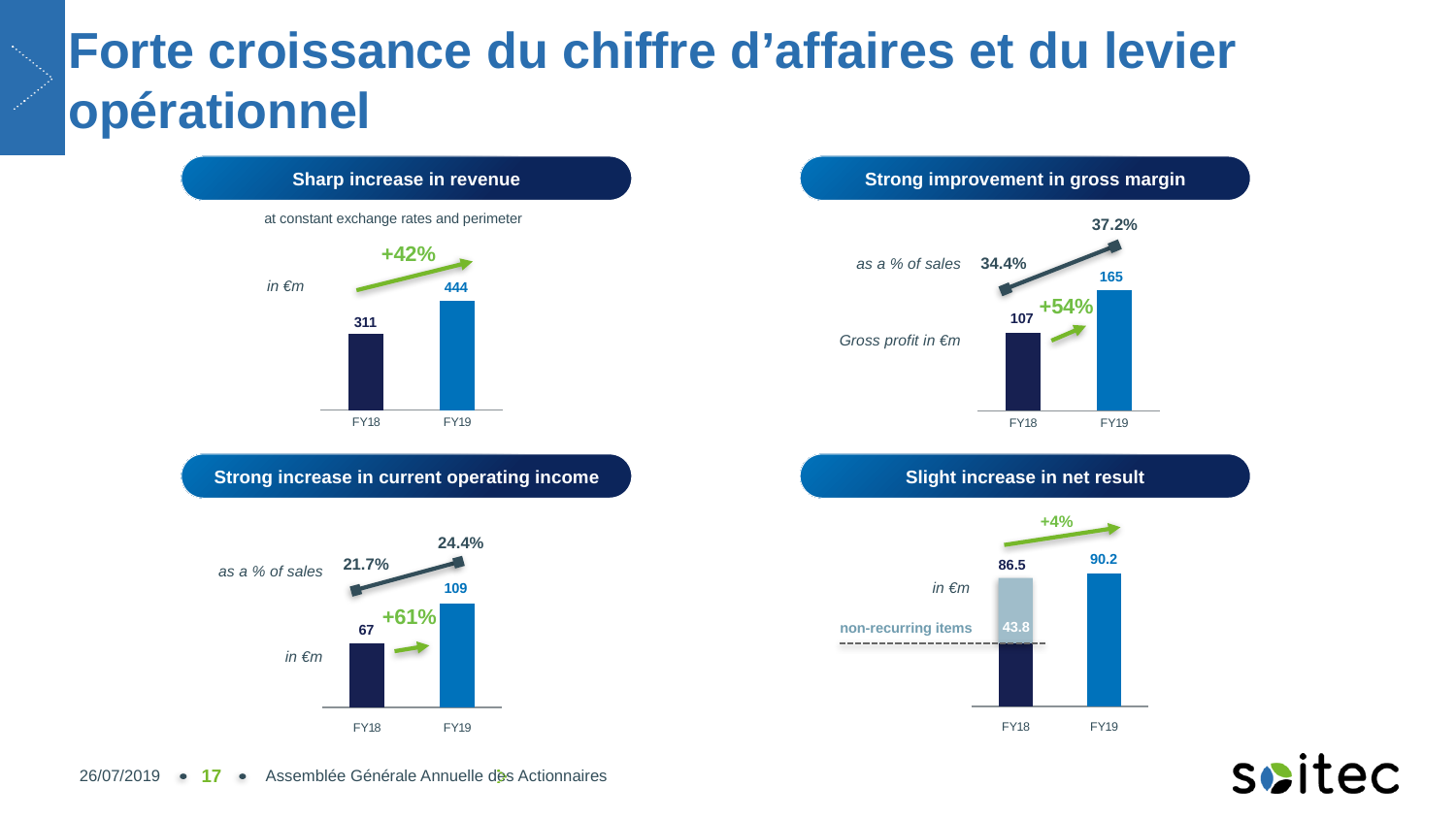
In the 'Strong increase in current operating income' chart, which year has the higher value, FY18 or FY19? FY19 In the 'Strong improvement in gross margin' chart, what is the gross margin as a % of sales for FY18? 34.4% In the 'Sharp increase in revenue' chart, what is the revenue for FY19? 444 What kind of chart is used in the 'Sharp increase in revenue' panel? Bar chart In the 'Slight increase in net result' chart, what is the value of the non-recurring items in FY18? 43.8 In the 'Strong improvement in gross margin' chart, what is the gross profit in €m for FY19? 165 In the 'Sharp increase in revenue' chart, what is the revenue for FY18? 311 In the 'Strong increase in current operating income' chart, what is the current operating income as a % of sales for FY19? 24.4% In the 'Strong improvement in gross margin' chart, what percentage growth is shown between FY18 and FY19? +54% In the 'Sharp increase in revenue' chart, what is the difference between the FY19 and FY18 values? 133 In the 'Strong increase in current operating income' chart, what is the current operating income in €m for FY18? 67 In the 'Slight increase in net result' chart, what is the net result in €m for FY19? 90.2